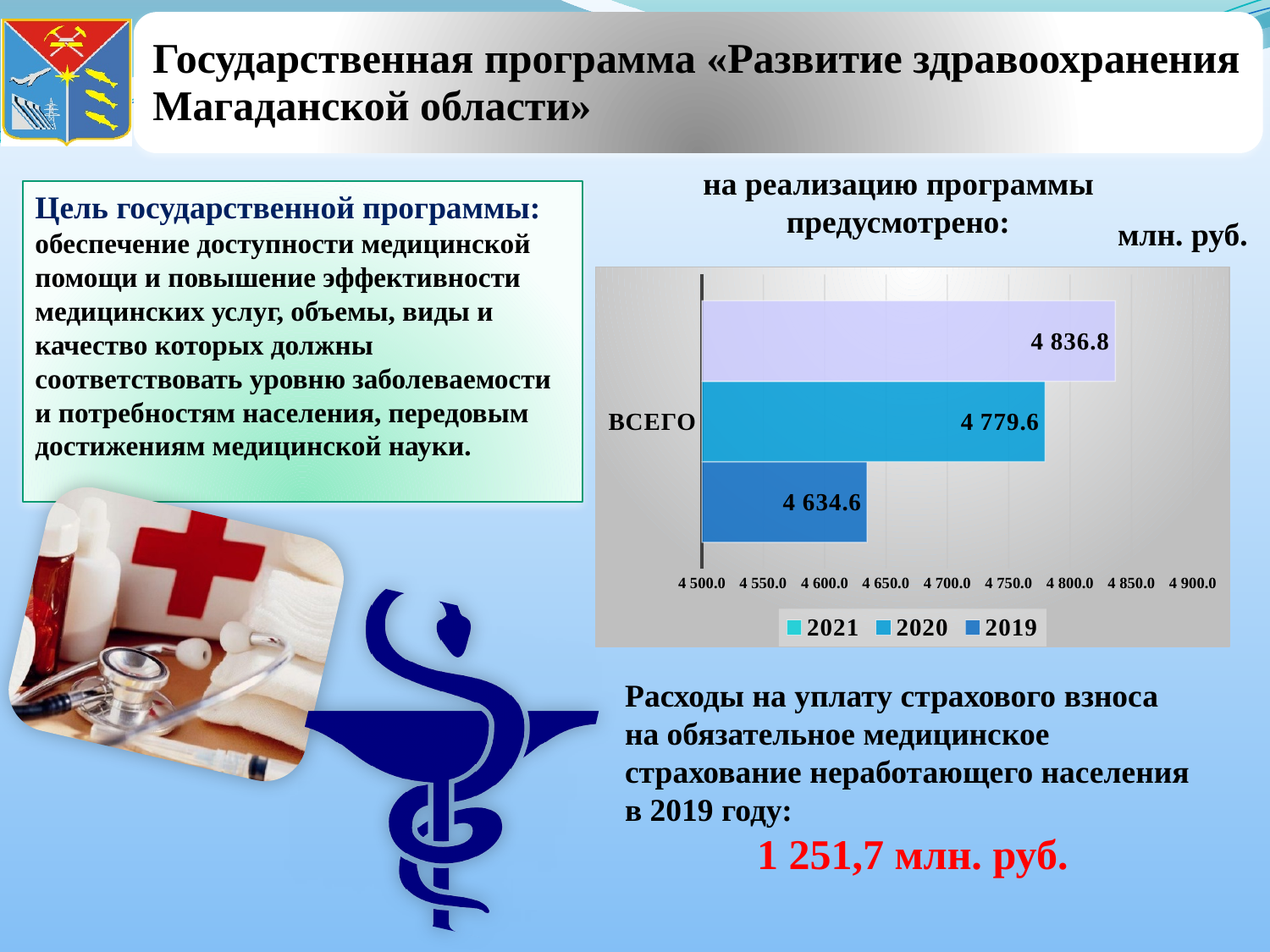
What unit is indicated for the values in the chart? млн. руб. What kind of chart is shown on the slide? bar chart What is the difference between the values for 2020 and 2019? 145.0 Which is larger, the value for 2020 or the value for 2019? 2020 What is the value for 2019 in the chart? 4 634.6 What is the difference between the values for 2021 and 2020? 57.2 What is the category label shown on the vertical axis of the chart? ВСЕГО Which year has the highest value in the chart? 2021 What is the value for 2020 in the chart? 4 779.6 How many series does the legend list? 3 What is the value for 2021 in the chart? 4 836.8 Which year has the lowest value in the chart? 2019